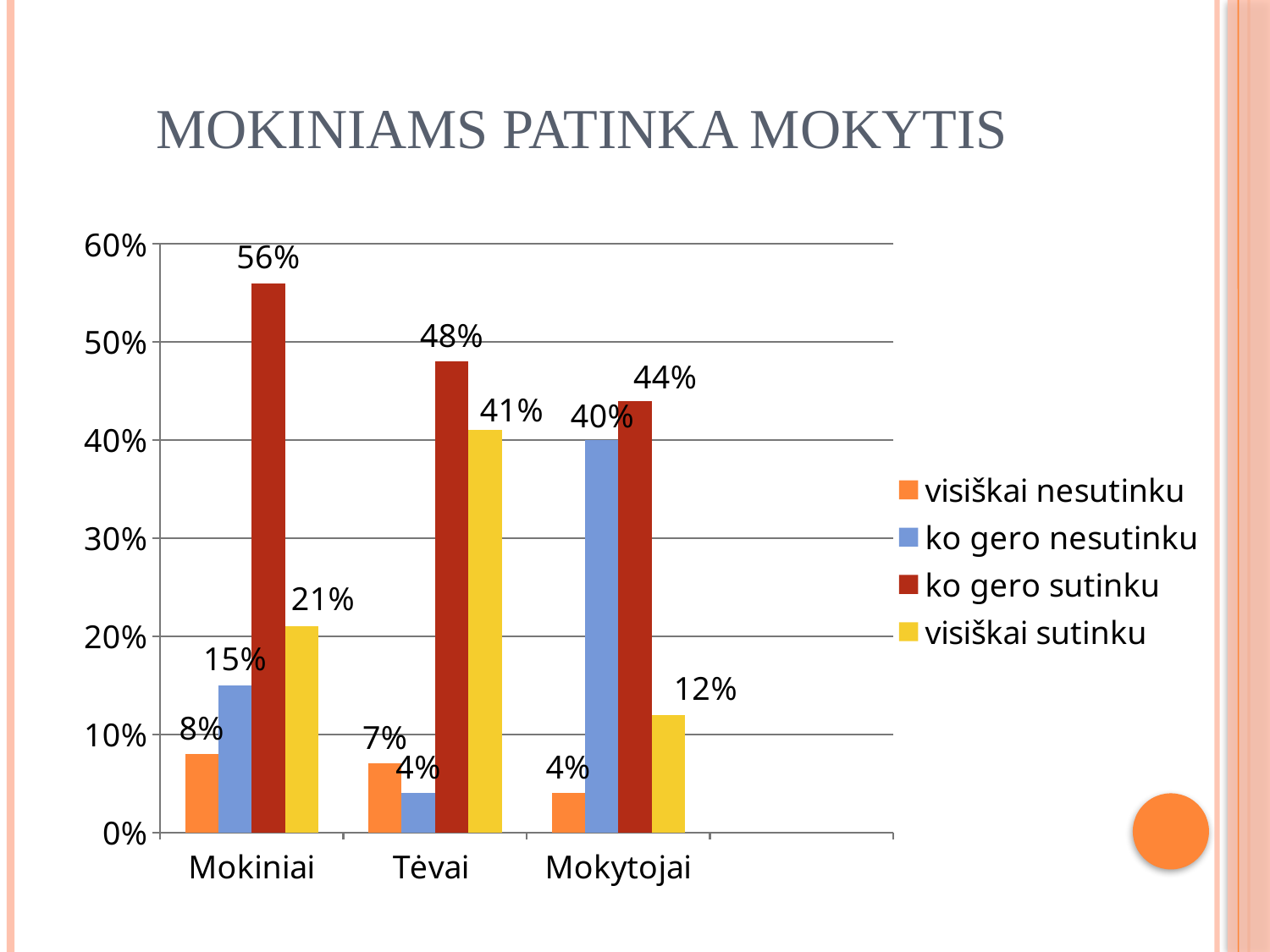
Which is larger in the Mokytojai category: 'ko gero nesutinku' or 'ko gero sutinku'? ko gero sutinku How many series does the legend list? 4 What kind of chart is shown on the slide? bar chart What is the difference between 'ko gero sutinku' and 'visiškai sutinku' in the Mokiniai category? 35% What is the value for 'visiškai sutinku' in the Tėvai category? 41% Is the value for 'ko gero sutinku' in the Tėvai category greater or less than 40%? greater How many categories are shown on the x axis? 3 Which category has the lowest value for 'visiškai sutinku'? Mokytojai Which category has the highest value for 'ko gero sutinku'? Mokiniai What is the title of the slide? MOKINIAMS PATINKA MOKYTIS What is the value for 'ko gero sutinku' in the Mokiniai category? 56% What is the value for 'ko gero nesutinku' in the Mokytojai category? 40%